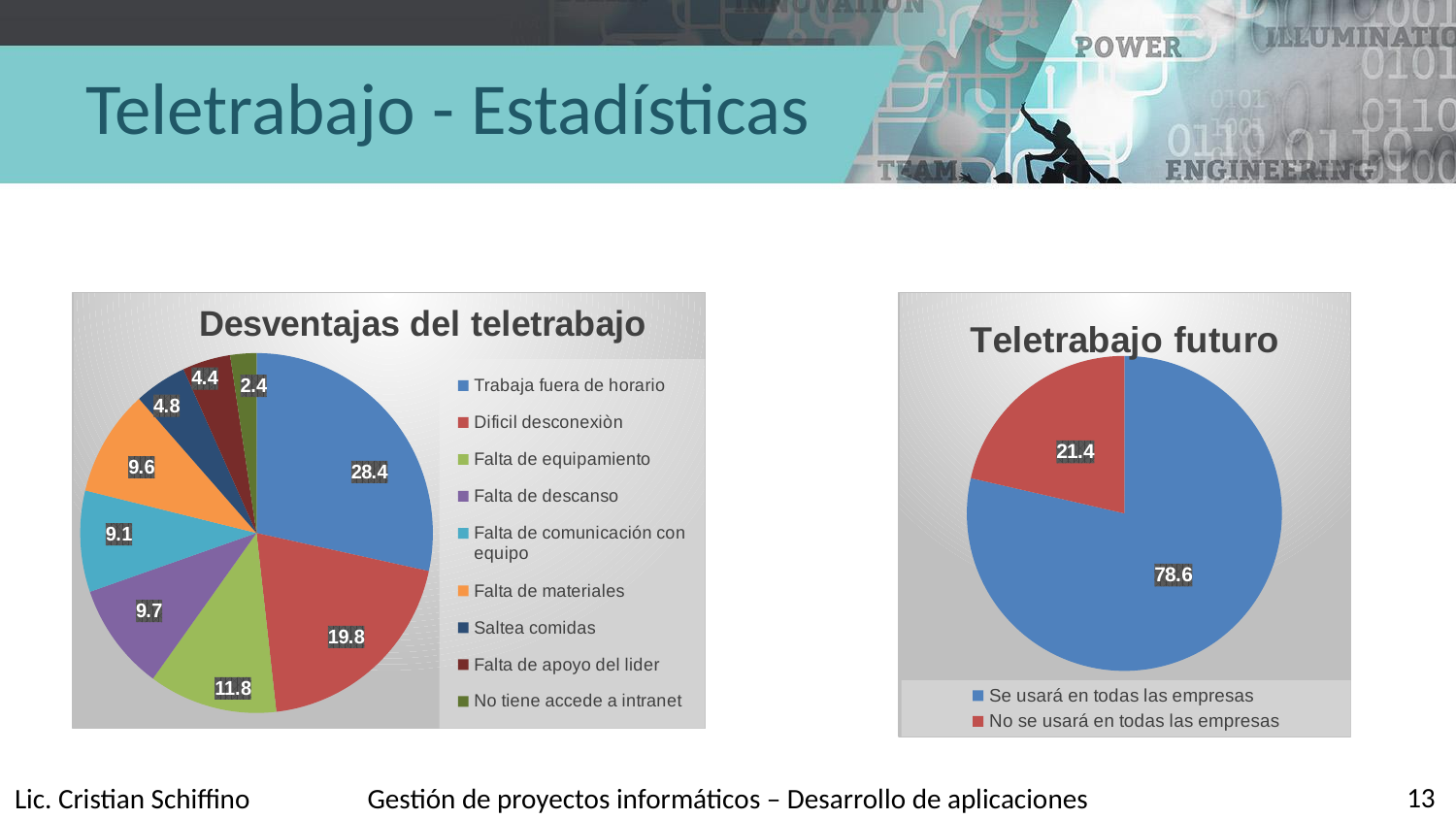
In the 'Desventajas del teletrabajo' chart, what colour is the slice for 'Falta de materiales'? Orange In the 'Desventajas del teletrabajo' chart, what is the value for 'Falta de equipamiento'? 11.8 In the 'Teletrabajo futuro' chart, what is the value for 'No se usará en todas las empresas'? 21.4 In the 'Desventajas del teletrabajo' chart, which category has the smallest slice? No tiene accede a intranet In the 'Teletrabajo futuro' chart, what is the value for 'Se usará en todas las empresas'? 78.6 In the 'Desventajas del teletrabajo' chart, which is larger: 'Saltea comidas' or 'Falta de apoyo del lider'? Saltea comidas What kind of chart is 'Teletrabajo futuro'? Pie chart How many entries does the legend of the 'Teletrabajo futuro' chart list? 2 In the 'Desventajas del teletrabajo' chart, what is the value for 'Trabaja fuera de horario'? 28.4 How many categories does the 'Desventajas del teletrabajo' chart show? 9 In the 'Desventajas del teletrabajo' chart, which category has the largest slice? Trabaja fuera de horario In the 'Desventajas del teletrabajo' chart, what is the difference between 'Trabaja fuera de horario' and 'Dificil desconexiòn'? 8.6